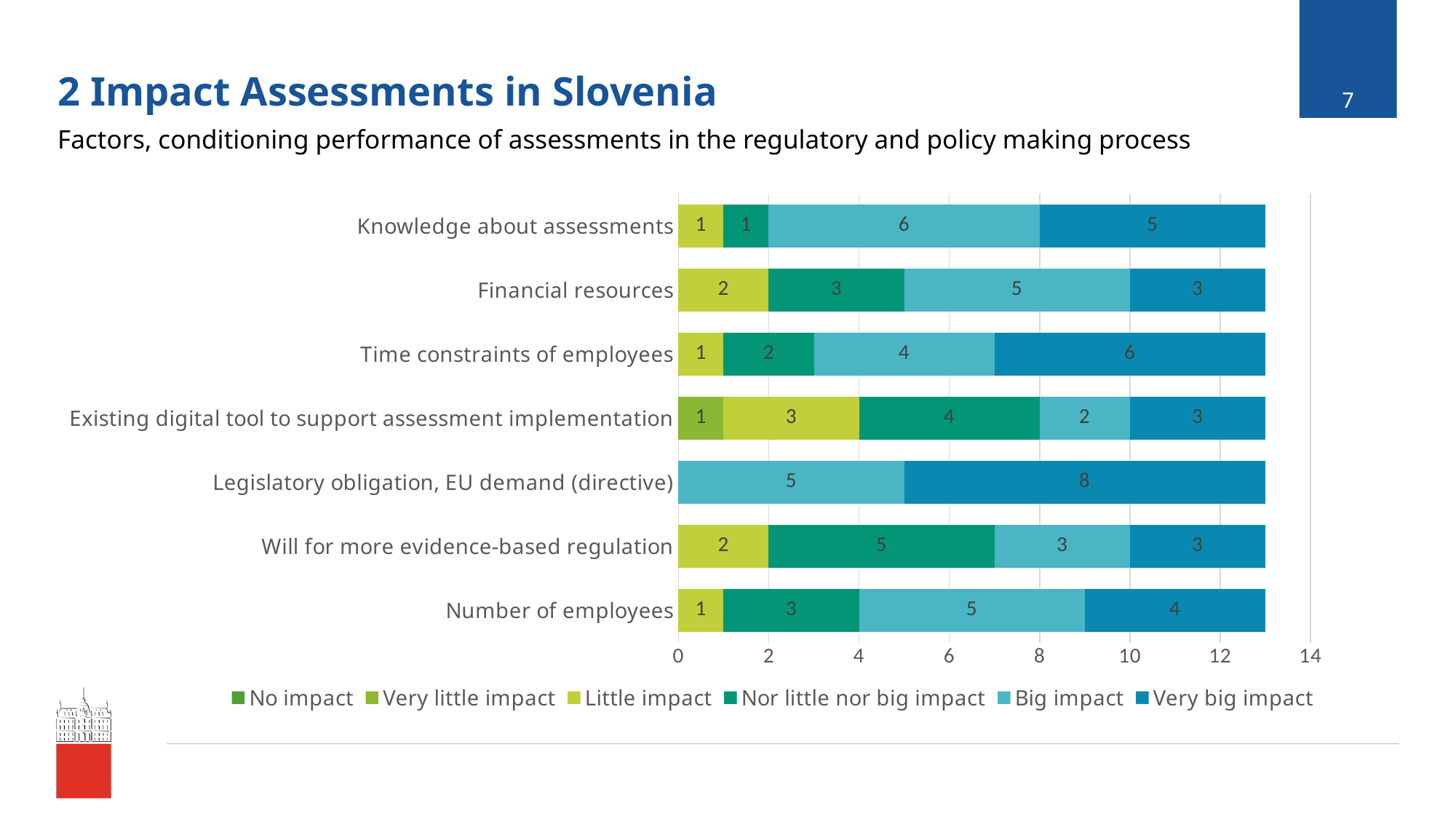
How many categories (factors) are plotted on the chart? 7 Which category has the lowest 'Big impact' value? Existing digital tool to support assessment implementation What is the 'Big impact' value for 'Knowledge about assessments'? 6 What is the total of the stacked bar for 'Existing digital tool to support assessment implementation'? 13 Which category is the only one with a 'Very little impact' segment? Existing digital tool to support assessment implementation What is the 'Nor little nor big impact' value for 'Will for more evidence-based regulation'? 5 What kind of chart is shown on the slide? Stacked bar chart What is the difference between the 'Very big impact' values for 'Time constraints of employees' and 'Financial resources'? 3 What is the 'Very big impact' value for 'Legislatory obligation, EU demand (directive)'? 8 Which category has the highest 'Very big impact' value? Legislatory obligation, EU demand (directive) Which is larger: the 'Big impact' value for 'Number of employees' or for 'Time constraints of employees'? Number of employees How many series does the legend list? 6